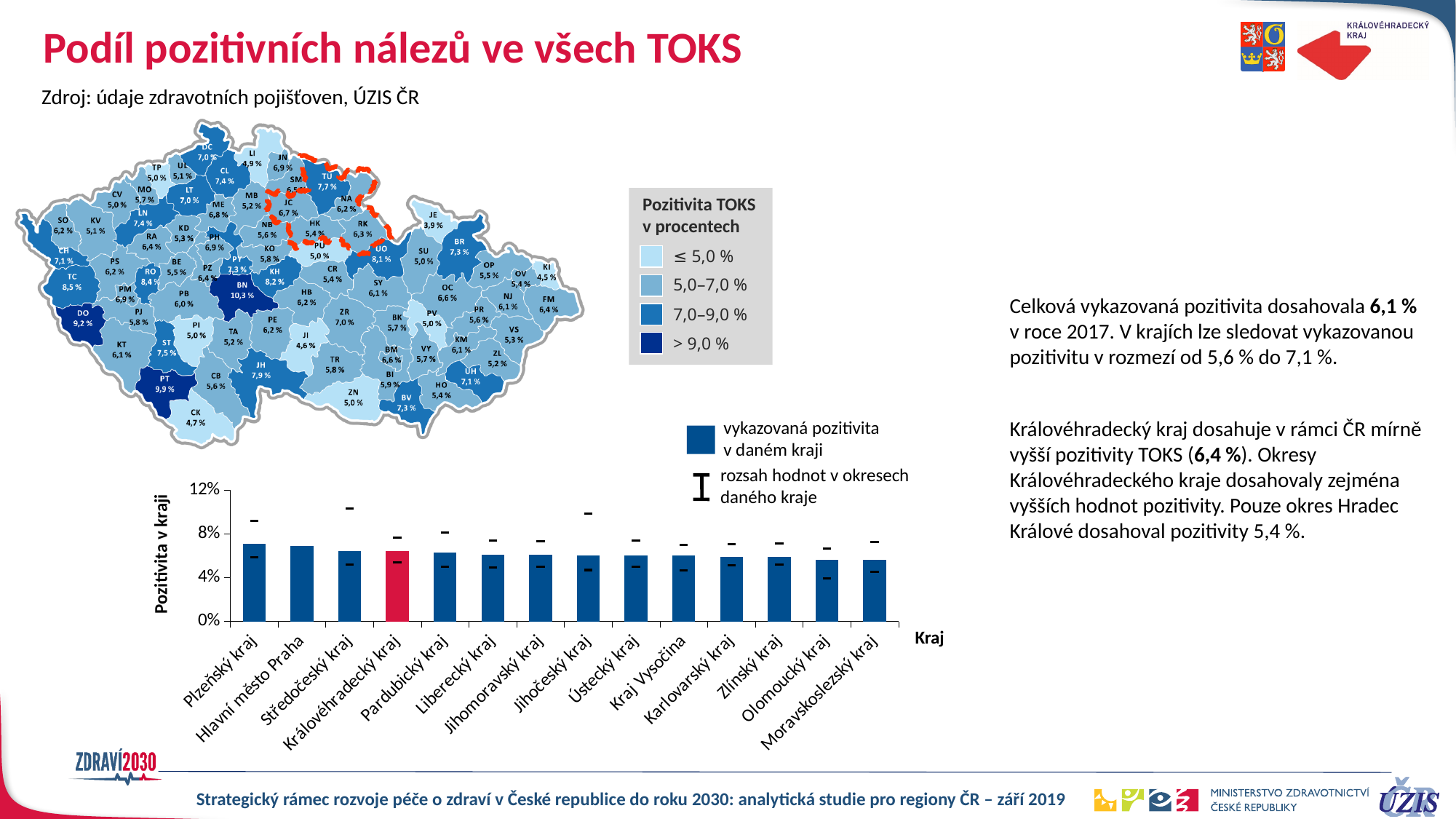
Which region's bar is highlighted in red in the bar chart? Královéhradecký kraj What is the label of the y axis of the bar chart? Pozitivita v kraji Which region has the highest bar in the bar chart? Plzeňský kraj Is the value for Plzeňský kraj in the bar chart greater or less than 8%? less In the bar chart, which is larger: the value for Plzeňský kraj or for Moravskoslezský kraj? Plzeňský kraj Is the value for Hlavní město Praha in the bar chart greater or less than 4%? greater Is the value for Moravskoslezský kraj in the bar chart greater or less than 4%? greater Do the bar values rise or fall moving from left to right along the x axis of the bar chart? fall How many regions (kraje) are shown on the x axis of the bar chart? 14 What kind of chart is shown at the bottom of the slide? bar chart In the bar chart, which is larger: the value for Hlavní město Praha or for Zlínský kraj? Hlavní město Praha